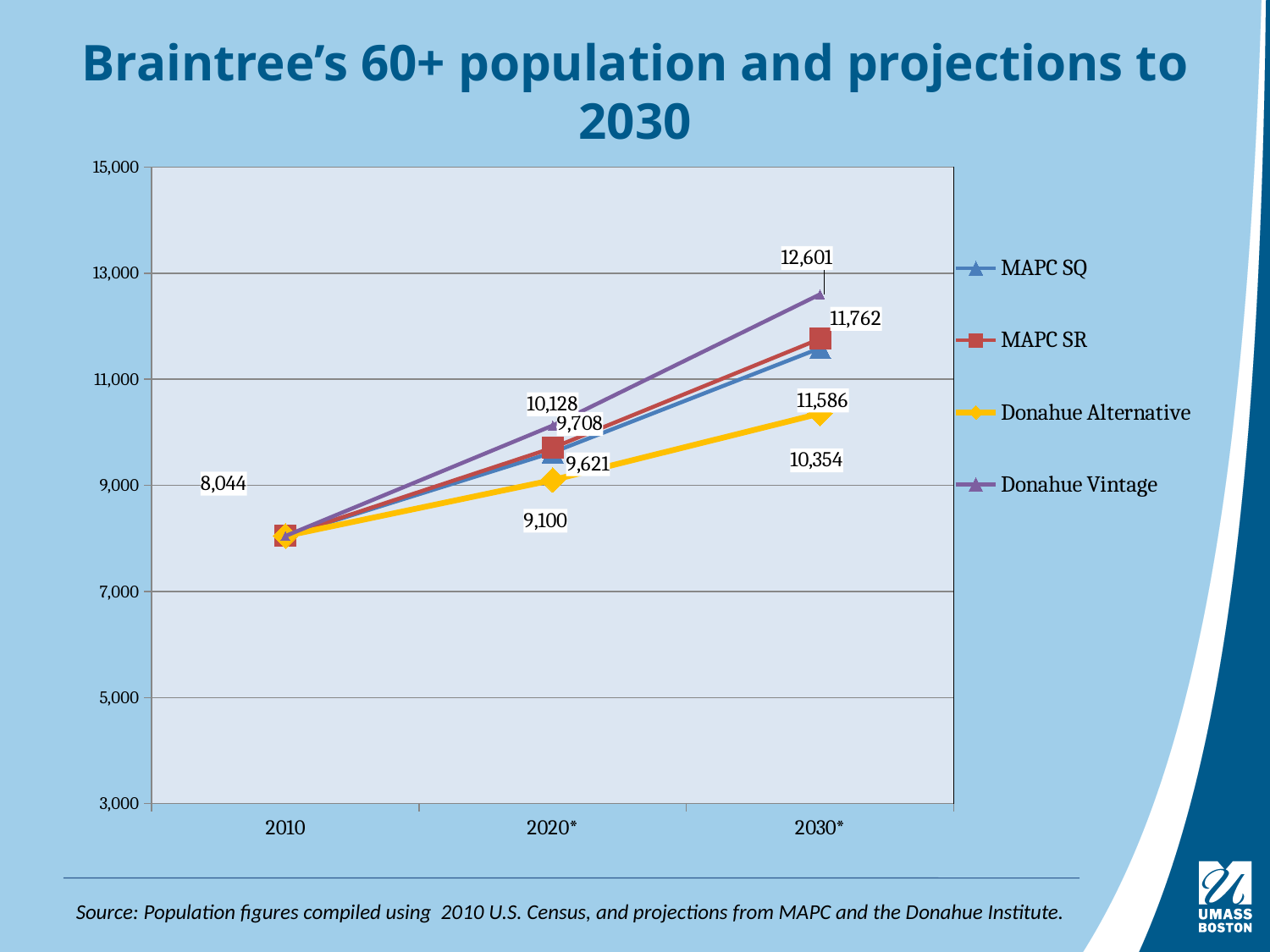
What is Braintree's 60+ population in 2010? 8,044 Which series has the lowest projected value for 2030*? Donahue Alternative What kind of chart is shown on the slide? Line chart How many years are shown on the x axis? 3 What is the difference between the Donahue Vintage and Donahue Alternative projections for 2030*? 2,247 What is the Donahue Alternative projection for 2020*? 9,100 What is the Donahue Vintage projection for 2030*? 12,601 What is the Donahue Alternative projection for 2030*? 10,354 How many series does the legend list? 4 Do the projected values rise or fall from 2010 to 2030*? Rise Which series has the highest projected value for 2030*? Donahue Vintage What is the Donahue Vintage projection for 2020*? 10,128